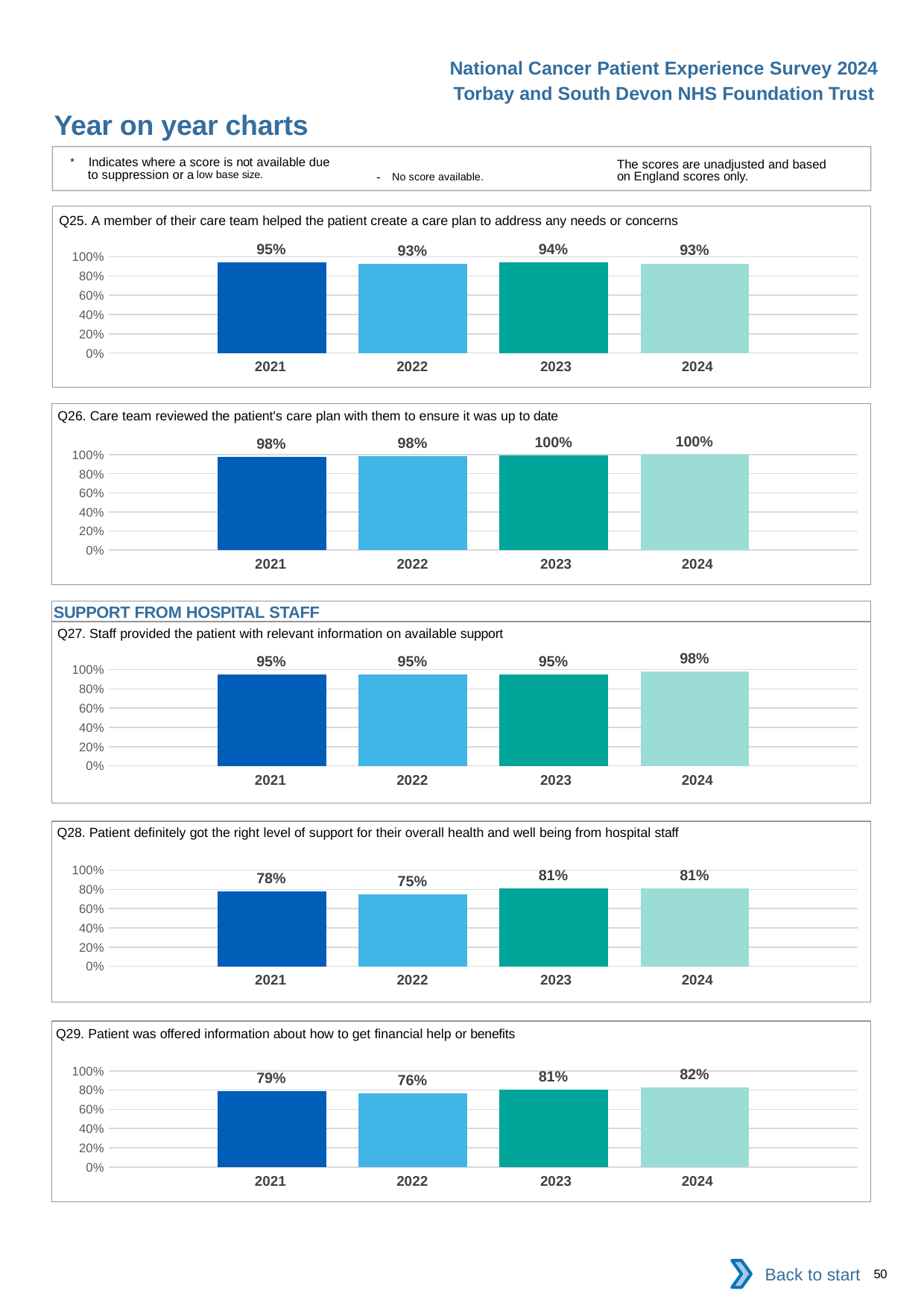
In the Q27 chart, what is the value for 2024? 98% In the Q26 chart, what is the difference between the 2023 value and the 2021 value? 2% In the Q26 chart, which years have the highest value? 2023 and 2024 In the Q25 chart, what is the value for 2021? 95% In the Q28 chart, is the value for 2021 larger or smaller than the value for 2023? smaller How many years are shown in the Q25 chart? 4 In the Q28 chart, which year has the lowest value? 2022 In the Q29 chart, what is the value for 2023? 81% What kind of chart is the Q26 chart? bar chart In the Q29 chart, what is the difference between the 2024 value and the 2022 value? 6% In the Q29 chart, is the value for 2022 greater or less than 80%? less What is the section heading shown above the Q27 chart? SUPPORT FROM HOSPITAL STAFF